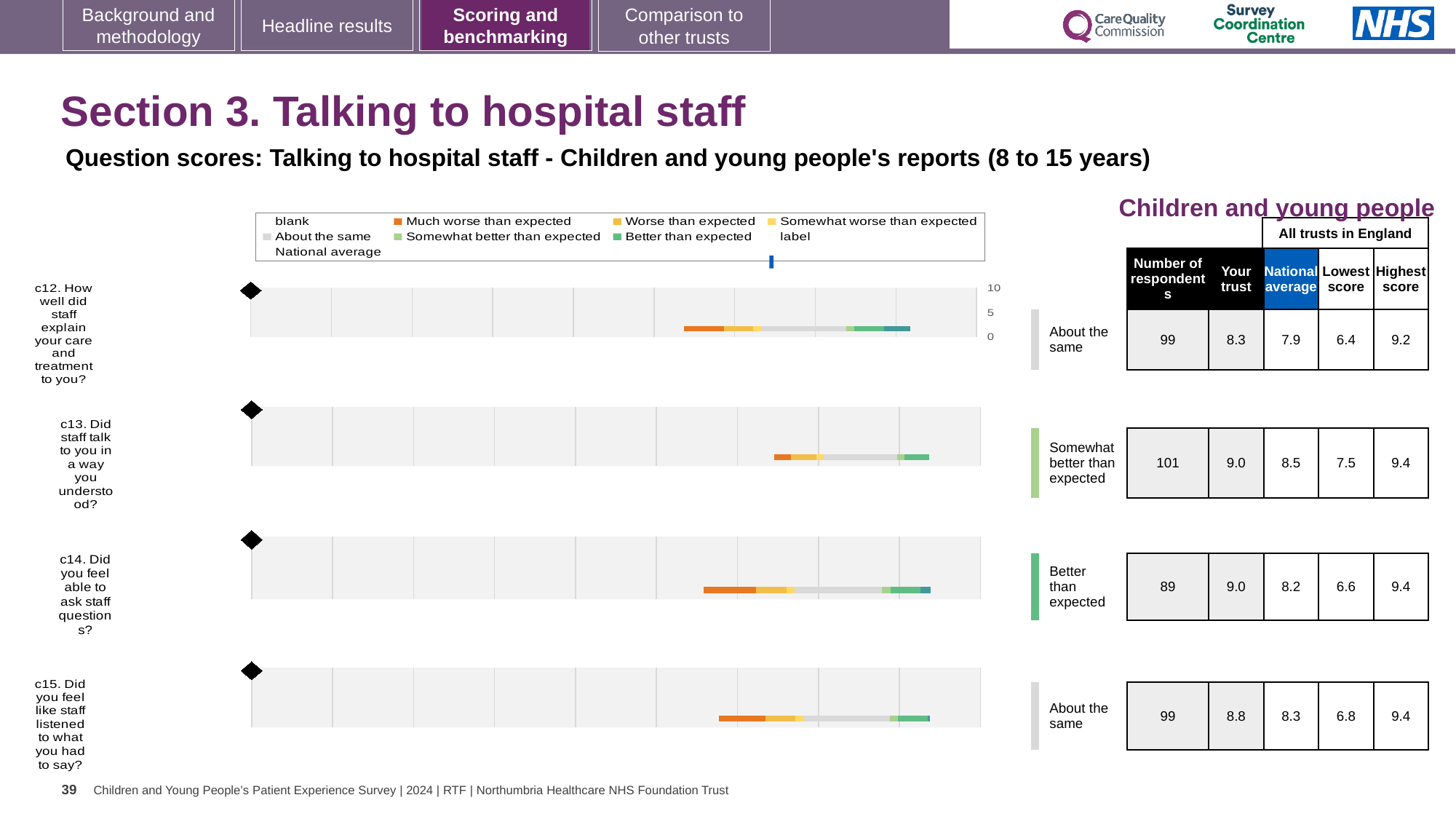
What kind of chart is used for each question (c12 to c15) on the slide? bar chart What benchmark category is shown next to the c13 chart? Somewhat better than expected For c12 (How well did staff explain your care and treatment to you?), what is the 'Your trust' score shown in the table? 8.3 For c15 (Did you feel like staff listened to what you had to say?), what is the difference between the 'Your trust' score and the national average? 0.5 What is the highest score among all trusts in England for c12? 9.2 What is the lowest score among all trusts in England for c15? 6.8 For c13 (Did staff talk to you in a way you understood?), what is the national average score? 8.5 Which question has the lowest 'Your trust' score in the table? c12 How many question charts (c12 to c15) are shown on the slide? 4 In the chart legend, what colour represents 'Much worse than expected'? orange For c14 (Did you feel able to ask staff questions?), which is larger: the 'Your trust' score or the national average? Your trust How many respondents are listed for c14 (Did you feel able to ask staff questions?)? 89